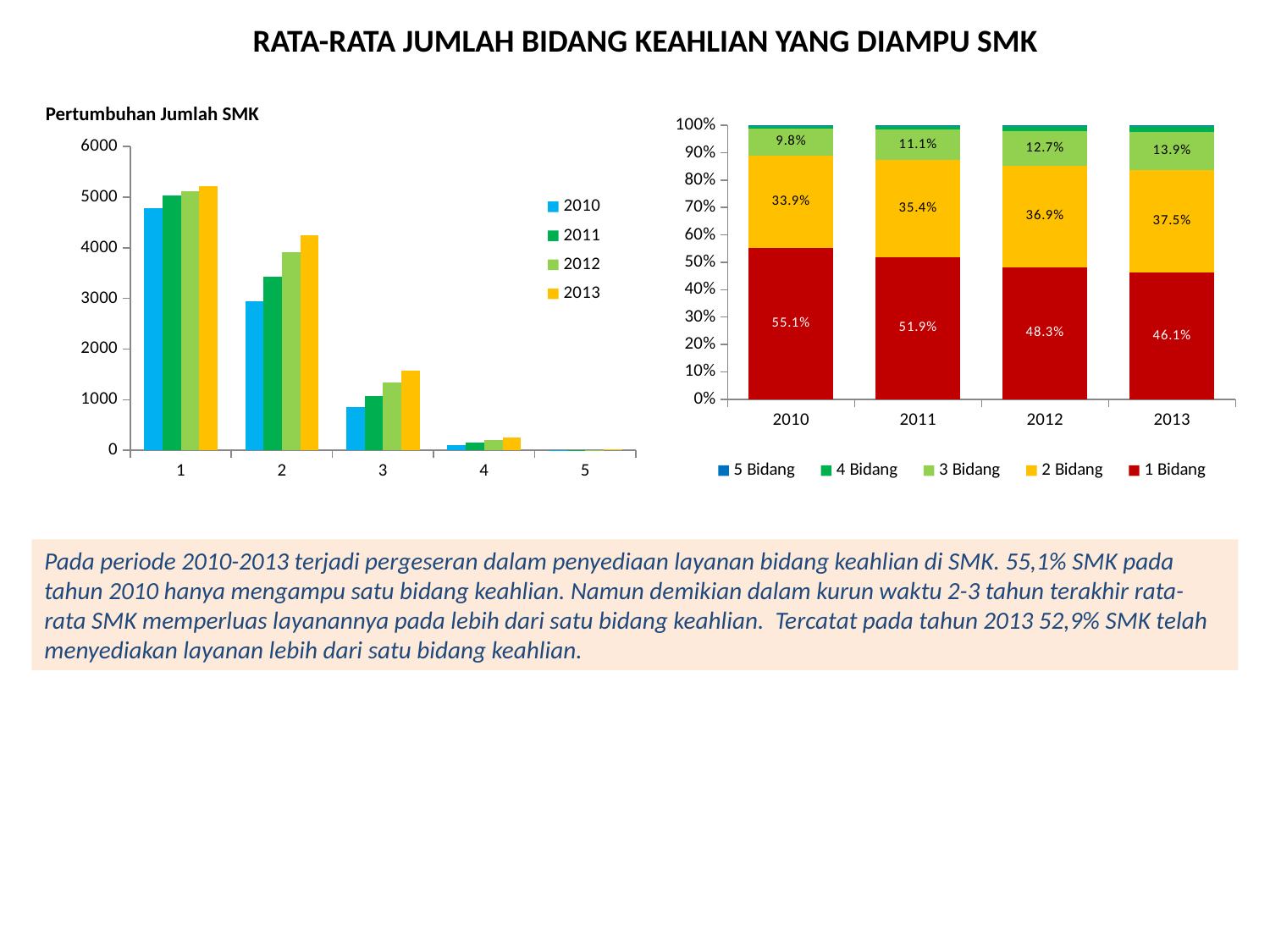
In the right-hand stacked chart, what percentage of SMK had 1 Bidang in 2010? 55.1% What kind of chart is 'Pertumbuhan Jumlah SMK'? bar chart In the 'Pertumbuhan Jumlah SMK' chart, which year has the highest value in category 2? 2013 In the right-hand stacked chart, what is the value for 2 Bidang in 2013? 37.5% In the right-hand stacked chart, what is the value for 3 Bidang in 2012? 12.7% In the 'Pertumbuhan Jumlah SMK' chart, is the 2013 value for category 1 greater or less than 5000? greater How many categories are shown on the x axis of the 'Pertumbuhan Jumlah SMK' chart? 5 How many series does the legend of the 'Pertumbuhan Jumlah SMK' chart list? 4 In the right-hand stacked chart, which year has the highest 3 Bidang share? 2013 In the right-hand stacked chart, by how many percentage points did the 1 Bidang share fall from 2010 to 2013? 9.0 percentage points How many series does the legend of the right-hand stacked chart list? 5 In the right-hand stacked chart, does the 1 Bidang share rise or fall from 2010 to 2013? fall